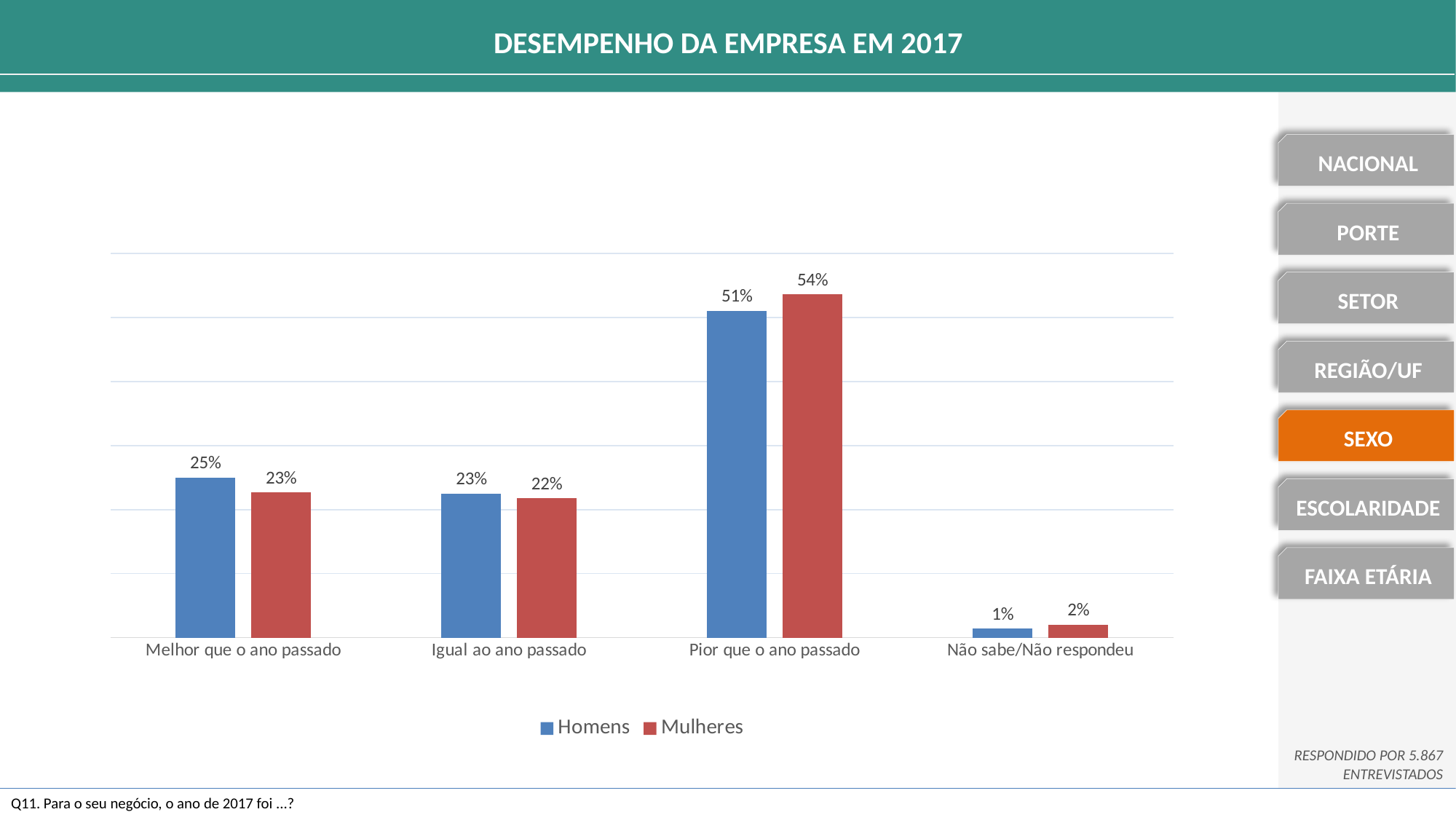
Which category has the lowest value for Homens? Não sabe/Não respondeu What is the value for Mulheres in the 'Melhor que o ano passado' category? 23% What is the value for Mulheres in the 'Não sabe/Não respondeu' category? 2% How many series does the legend list? 2 Which colour represents the Mulheres series? Red What is the value for Homens in the 'Pior que o ano passado' category? 51% In the 'Melhor que o ano passado' category, which series has the larger value, Homens or Mulheres? Homens What kind of chart is shown on the slide? Bar chart How many categories are shown on the x axis? 4 Which category has the highest value for Mulheres? Pior que o ano passado What is the difference between Mulheres and Homens in the 'Pior que o ano passado' category? 3% What is the title of the slide? DESEMPENHO DA EMPRESA EM 2017